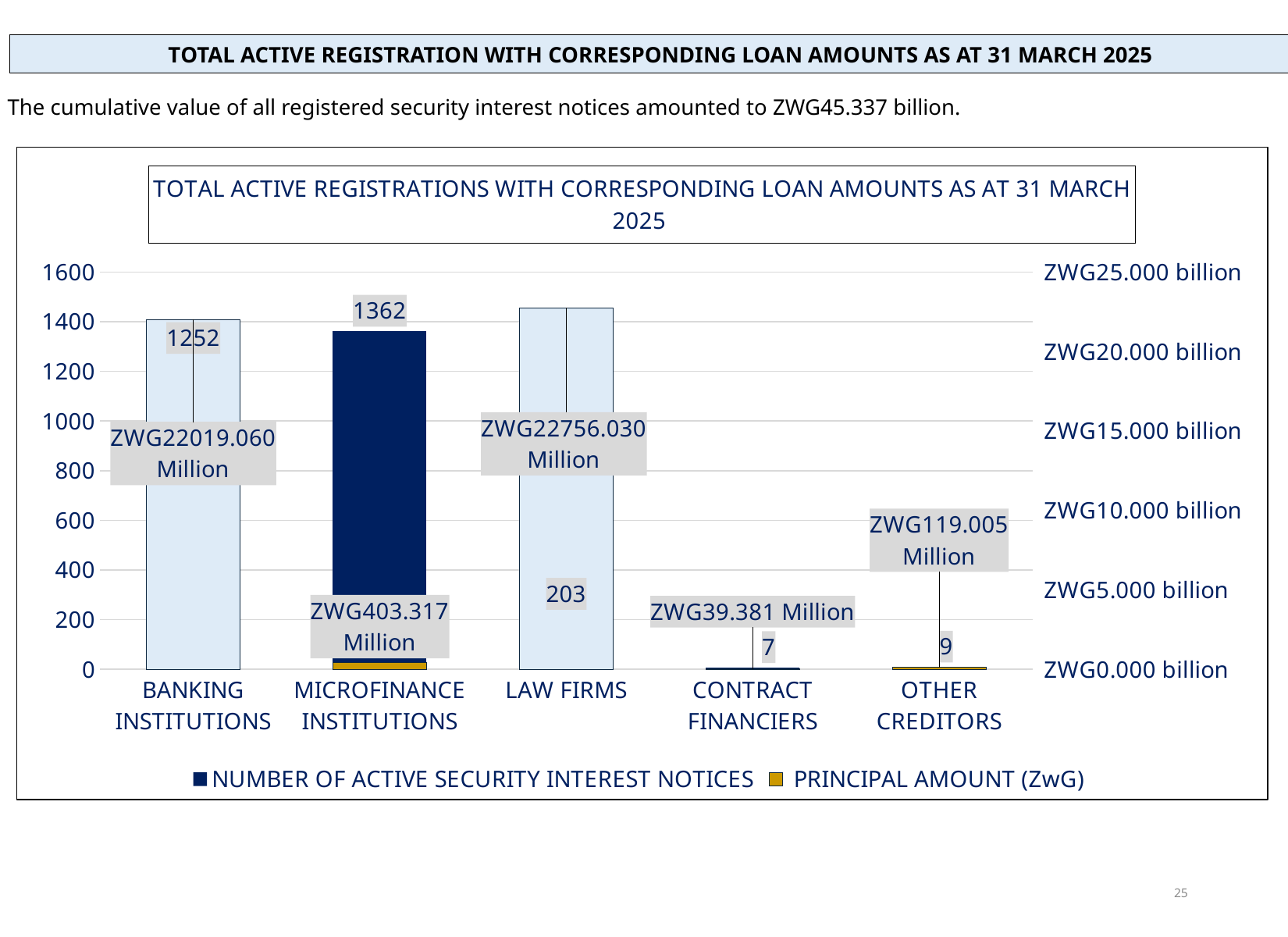
How many categories are shown on the x axis of the chart? 5 What is the highest value labelled on the right-hand axis of the chart? ZWG25.000 billion Which category has the highest number of active security interest notices? Microfinance Institutions Which has the larger principal amount, Banking Institutions or Law Firms? Law Firms How many active security interest notices are shown for Contract Financiers? 7 What kind of chart is shown on the slide? Bar chart What is the difference in the number of active security interest notices between Microfinance Institutions and Banking Institutions? 110 What is the principal amount shown for Other Creditors? ZWG119.005 Million What is the principal amount shown for Law Firms? ZWG22756.030 Million Which category has the lowest principal amount? Contract Financiers How many series does the chart legend list? 2 How many active security interest notices are shown for Microfinance Institutions? 1362